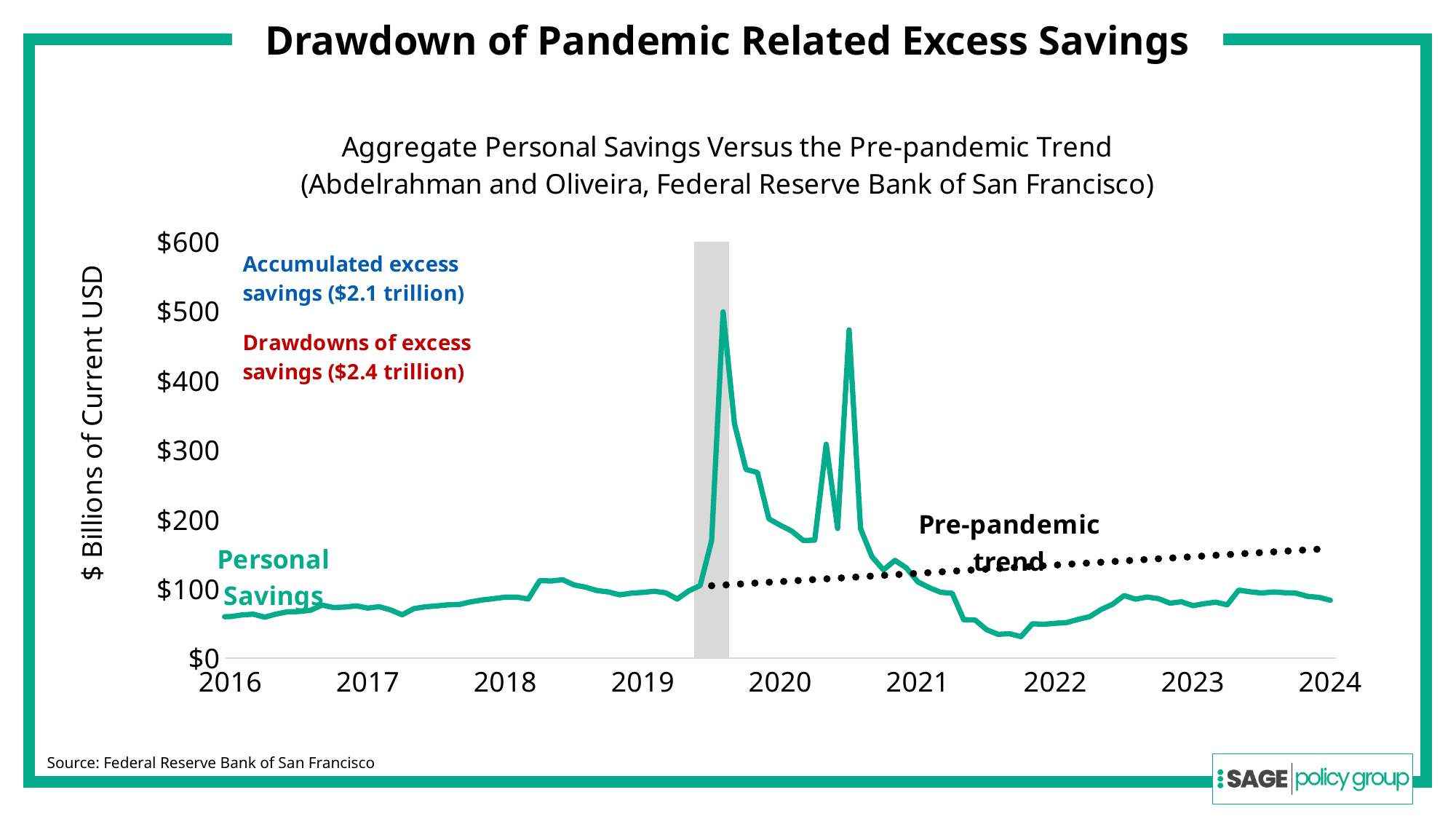
What kind of chart is shown on the slide? Line chart How many year labels are shown on the x axis? 9 Is the peak value of Personal Savings in 2020 greater or less than $400? greater Does Personal Savings rise or fall from 2016 to 2019? rise What are the names of the two series plotted on the chart? Personal Savings and Pre-pandemic trend Is the value of the Pre-pandemic trend at 2024 greater or less than $200? less Is the value of Personal Savings in late 2021 greater or less than $100? less Does the Pre-pandemic trend line rise or fall from 2019 to 2024? rise What is the chart's title? Aggregate Personal Savings Versus the Pre-pandemic Trend (Abdelrahman and Oliveira, Federal Reserve Bank of San Francisco)